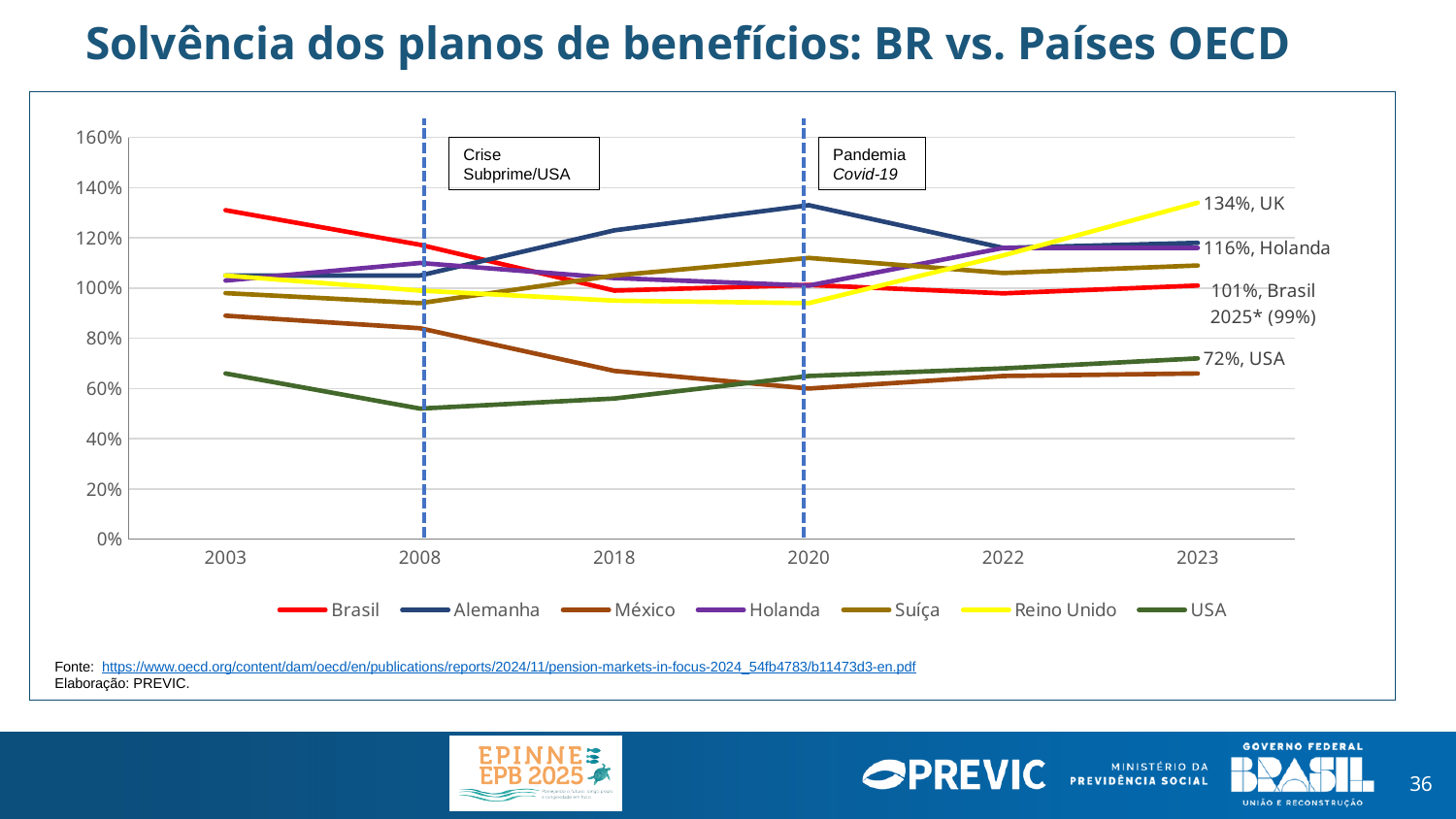
What is the value for USA in 2023? 72% Is the value for USA in 2008 greater or less than 60%? less How many years are shown on the x axis? 6 What is the value for Holanda in 2023? 116% What kind of chart is shown on the slide? line chart What is the value for the UK (Reino Unido) in 2023? 134% What is the difference between the 2023 values for the UK and the USA? 62 percentage points Does the USA line rise or fall from 2008 to 2023? rise Which series has the highest value in 2023? Reino Unido (UK) How many series does the legend list? 7 What is the value for Brasil in 2023? 101% Which event is marked by the dashed vertical line at 2020? Pandemia Covid-19